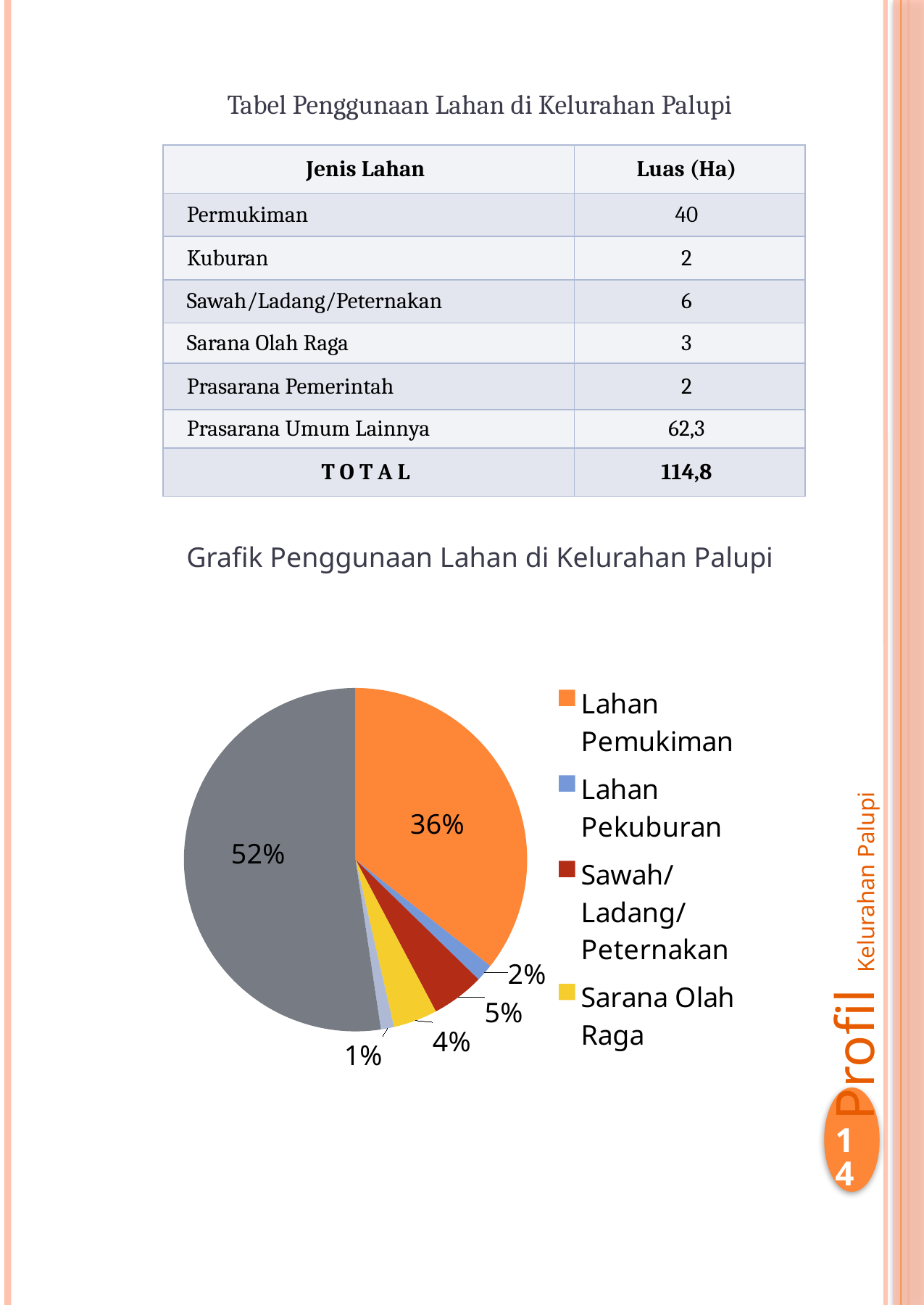
In the pie chart, what percentage is shown for Lahan Pemukiman? 36% Which has a larger share in the pie chart, Sawah/Ladang/Peternakan or Sarana Olah Raga? Sawah/Ladang/Peternakan What is the title of the pie chart? Grafik Penggunaan Lahan di Kelurahan Palupi In the pie chart, how many percentage points larger is the Lahan Pemukiman share than the Sawah/Ladang/Peternakan share? 31 percentage points What is the smallest percentage label shown on the pie chart? 1% What is the largest percentage label shown on the pie chart? 52% What colour is the Lahan Pemukiman slice in the pie chart? Orange How many slices does the pie chart have? 6 What type of chart is shown under the title 'Grafik Penggunaan Lahan di Kelurahan Palupi'? Pie chart In the pie chart, what percentage is shown for Sarana Olah Raga? 4% In the pie chart, what percentage is shown for Sawah/Ladang/Peternakan? 5% In the pie chart, what percentage is shown for Lahan Pekuburan? 2%